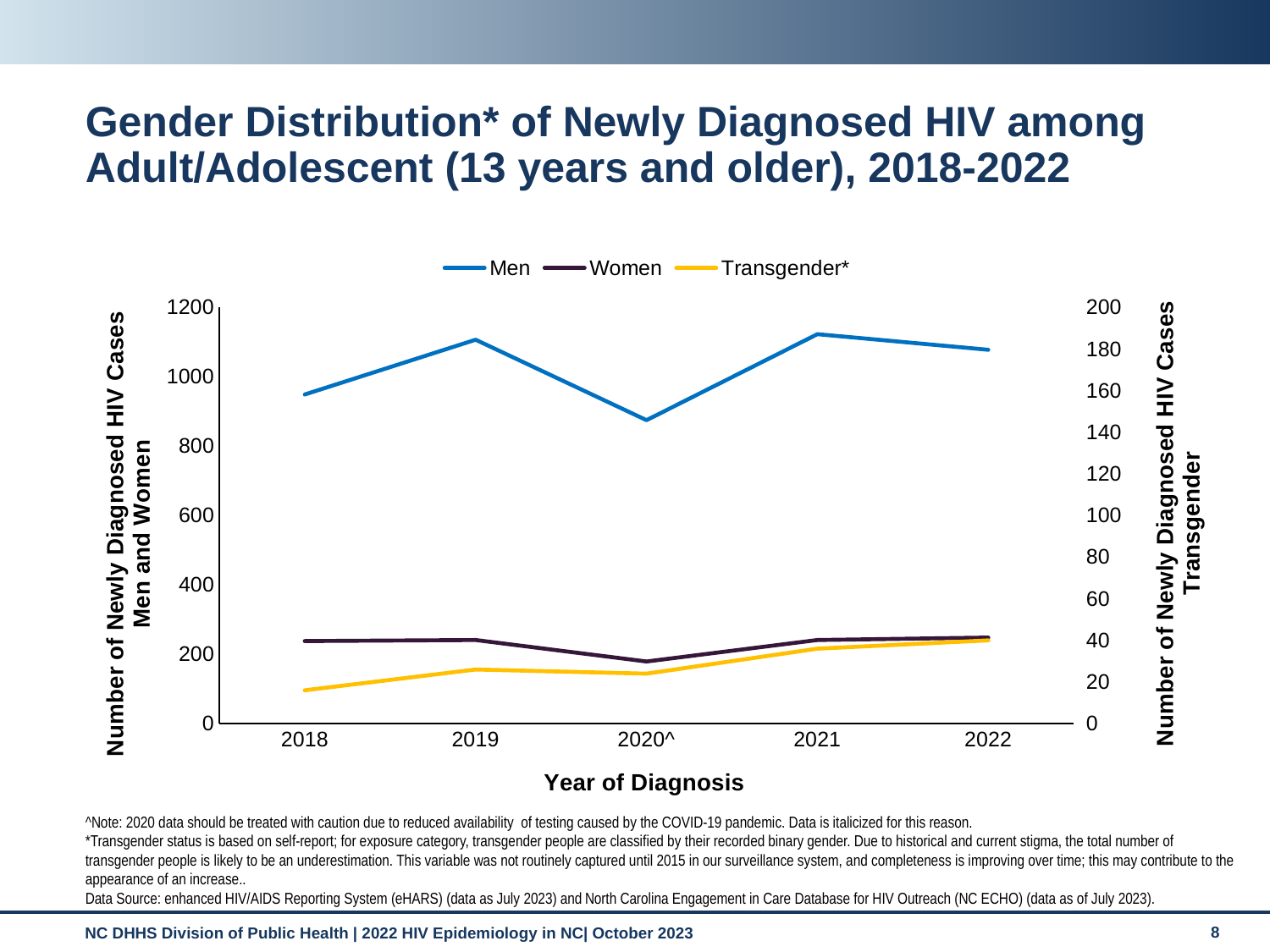
Which series has the larger value in 2022, Men or Women? Men How many series does the legend list? 3 What kind of chart is shown on the slide? line chart Is the value for Men in 2018 greater or less than 800? greater In which year is the Transgender* series at its lowest? 2018 Does the Transgender* series generally rise or fall from 2018 to 2022? rise How many years of diagnosis are plotted along the x axis? 5 Which series is drawn in blue? Men In which year is the Men series at its lowest? 2020^ Is the value for Transgender* in 2022, read on the right axis, greater or less than 20? greater Is the value for Men in 2020^ greater or less than 1000? less